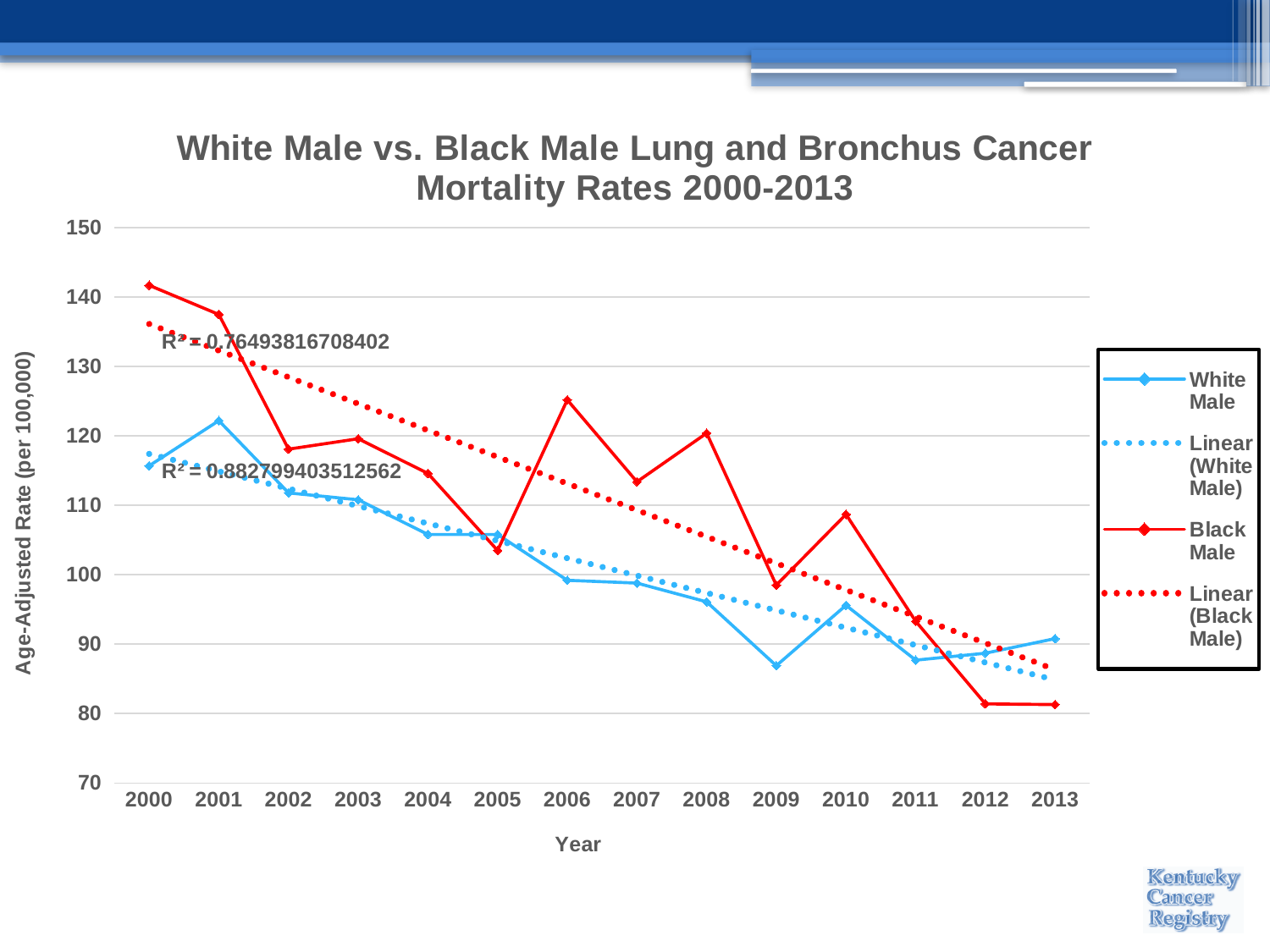
In which year is the Black Male mortality rate highest? 2000 Is the Black Male value for 2012 greater or less than 90? less What kind of chart is shown on the slide? line chart How many years are plotted along the x axis? 14 In which year is the White Male mortality rate highest? 2001 Is the Black Male value for 2006 greater or less than 120? greater Overall, do the Black Male mortality rates rise or fall from 2000 to 2013? fall Is the White Male value for 2009 greater or less than 90? less In 2013, which series has the larger value, White Male or Black Male? White Male How many entries does the legend list? 4 What is the R² value shown for the White Male linear trendline? 0.882799403512562